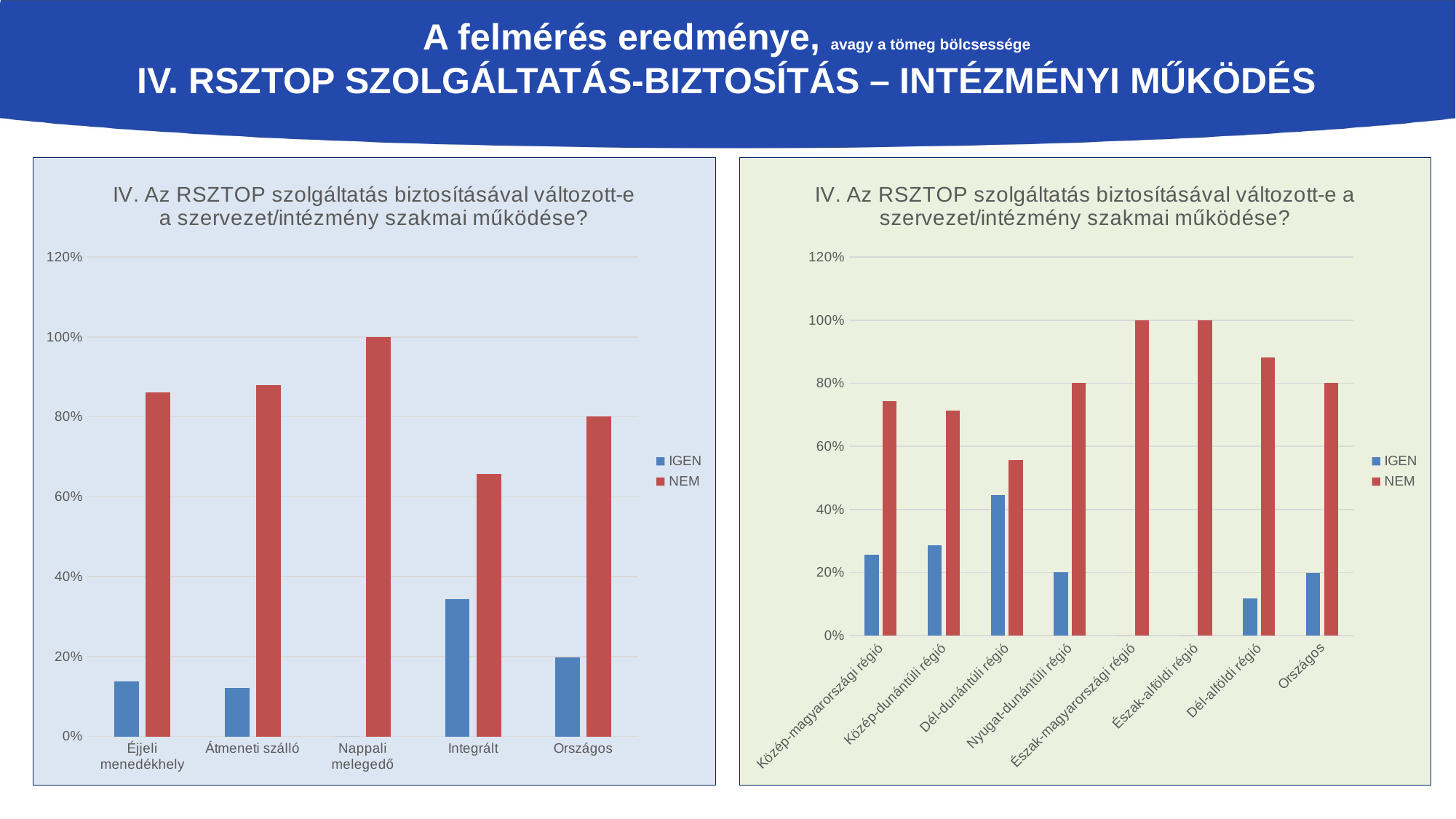
How many categories are shown on the x axis of the right chart? 8 How many series does the legend of the left chart list? 2 In the left chart, which category has the highest NEM value? Nappali melegedő In the right chart, which region has the highest IGEN value? Dél-dunántúli régió In the left chart, what is the NEM value for Nappali melegedő? 100% In the left chart, is the NEM value for Éjjeli menedékhely greater or less than 80%? greater In the left chart, which category has the highest IGEN value? Integrált In the right chart, is the NEM value for Dél-dunántúli régió greater or less than 60%? less In the right chart, what is the NEM value for Észak-magyarországi régió? 100% How many categories are shown on the x axis of the left chart? 5 In the right chart, which is larger: the IGEN value for Közép-magyarországi régió or for Dél-alföldi régió? Közép-magyarországi régió What kind of chart is the left chart? bar chart